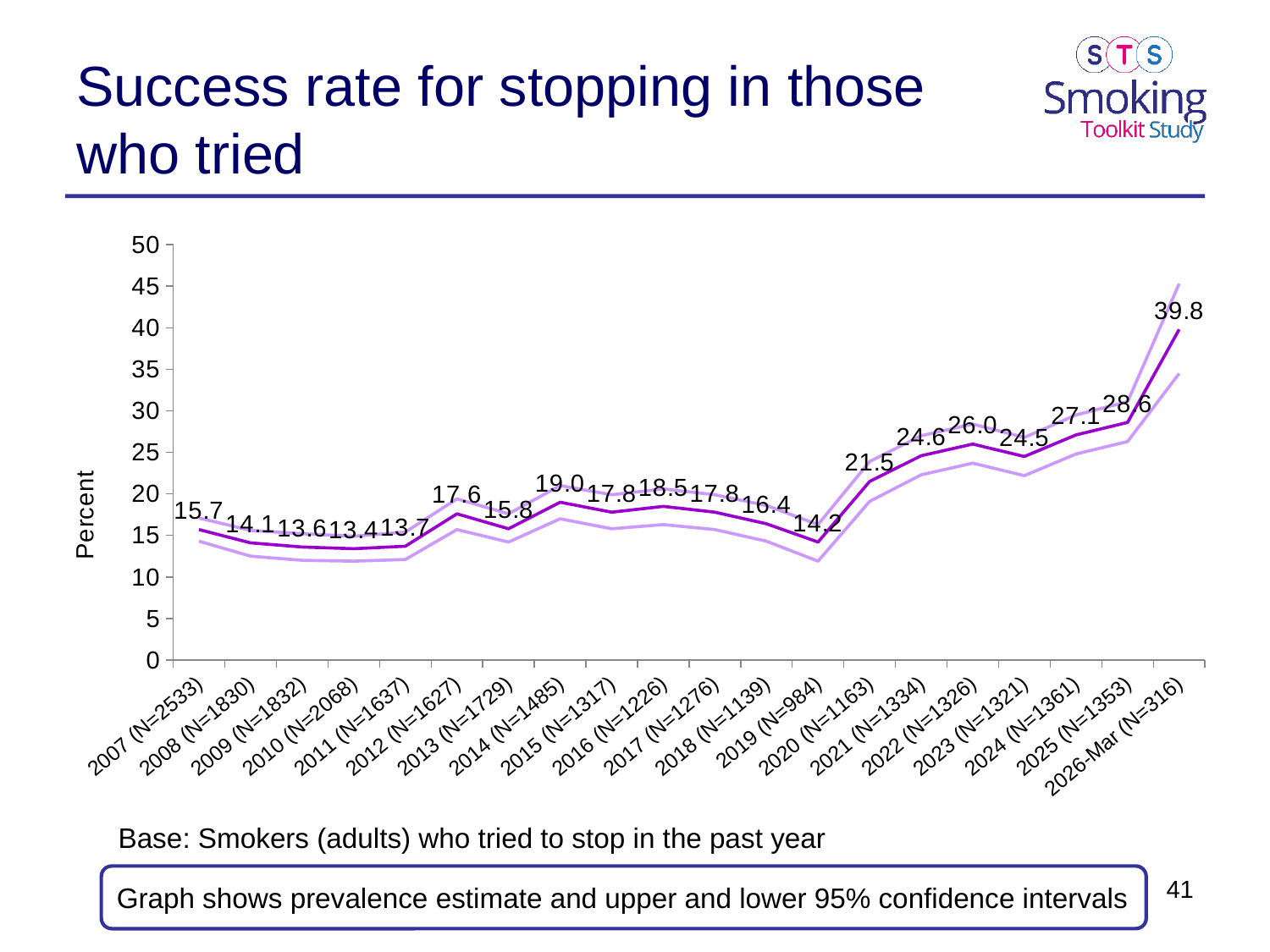
What is the label on the y axis? Percent What is the success rate for 2007 (N=2533)? 15.7 How many years are plotted on the x axis? 20 Which year has a higher success rate, 2014 (N=1485) or 2016 (N=1226)? 2014 (N=1485) What is the difference between the success rate in 2020 (N=1163) and 2019 (N=984)? 7.3 Which year has the lowest success rate? 2010 (N=2068) What is the success rate for 2026-Mar (N=316)? 39.8 What is the success rate for 2019 (N=984)? 14.2 What type of chart is shown? Line chart By how much did the success rate increase from 2025 (N=1353) to 2026-Mar (N=316)? 11.2 Does the success rate rise or fall from 2019 (N=984) to 2026-Mar (N=316)? Rise Which year has the highest success rate? 2026-Mar (N=316)